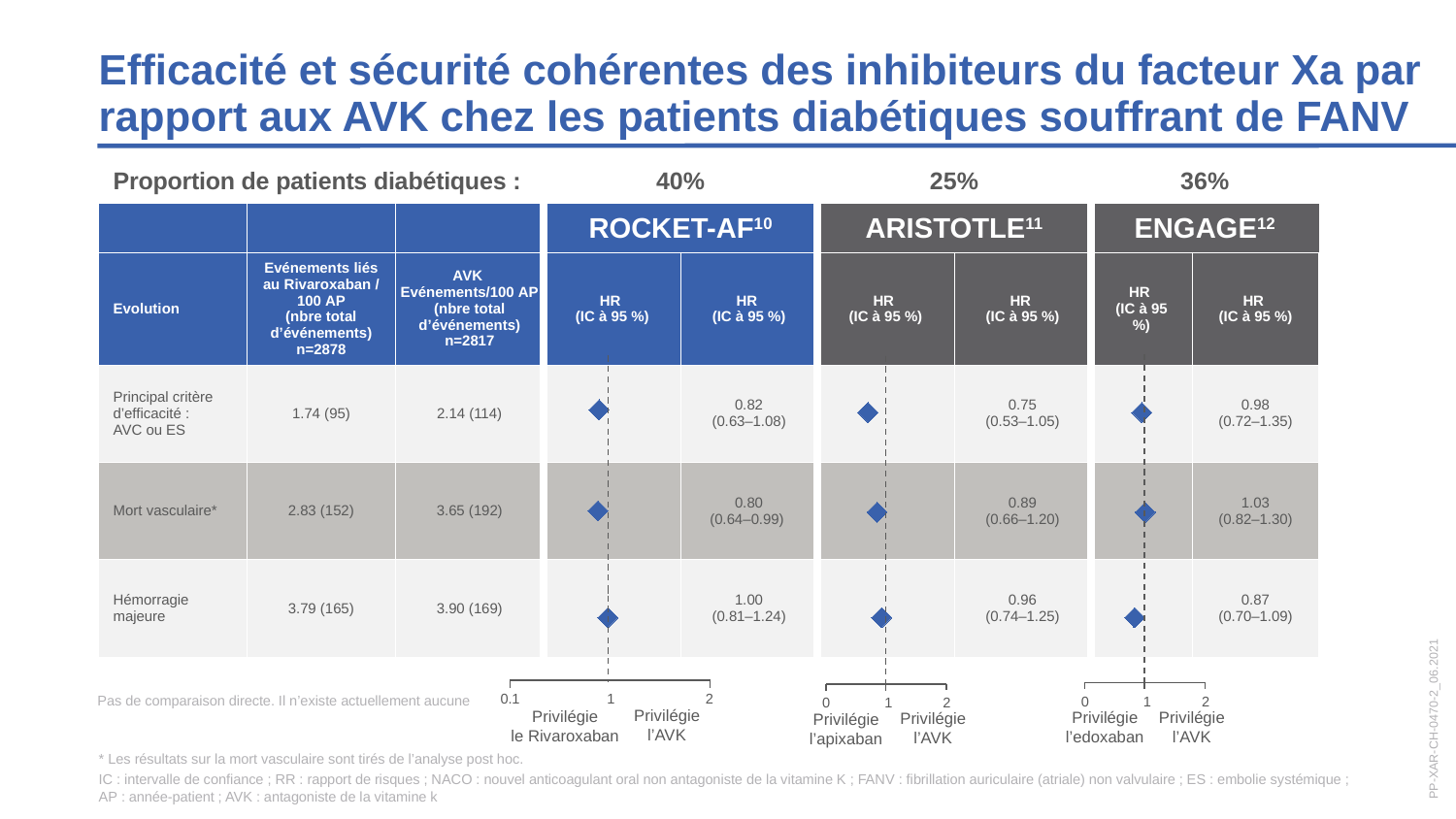
In the ROCKET-AF forest plot, what is the HR for the primary efficacy endpoint (AVC ou ES)? 0.82 In the ARISTOTLE forest plot, what is the HR for Mort vasculaire? 0.89 In the ROCKET-AF forest plot, what does the left side of the x axis favour according to its label? Privilégie le Rivaroxaban In the ENGAGE forest plot, what is the difference between the HR for Mort vasculaire and the HR for the primary efficacy endpoint (AVC ou ES)? 0.05 How many outcomes are plotted in each forest plot? 3 In the ENGAGE forest plot, what is the HR for Hémorragie majeure? 0.87 In the ENGAGE forest plot, is the HR for Mort vasculaire greater or less than 1? greater In the ROCKET-AF forest plot, which outcome has the highest HR? Hémorragie majeure In the ARISTOTLE forest plot, which outcome has the lowest HR? Principal critère d'efficacité : AVC ou ES What kind of chart is used to display the hazard ratios for ROCKET-AF, ARISTOTLE and ENGAGE? Forest plot For Mort vasculaire, which study shows the larger HR: ROCKET-AF or ARISTOTLE? ARISTOTLE In the ROCKET-AF forest plot, what is the 95% confidence interval for Mort vasculaire? (0.64–0.99)